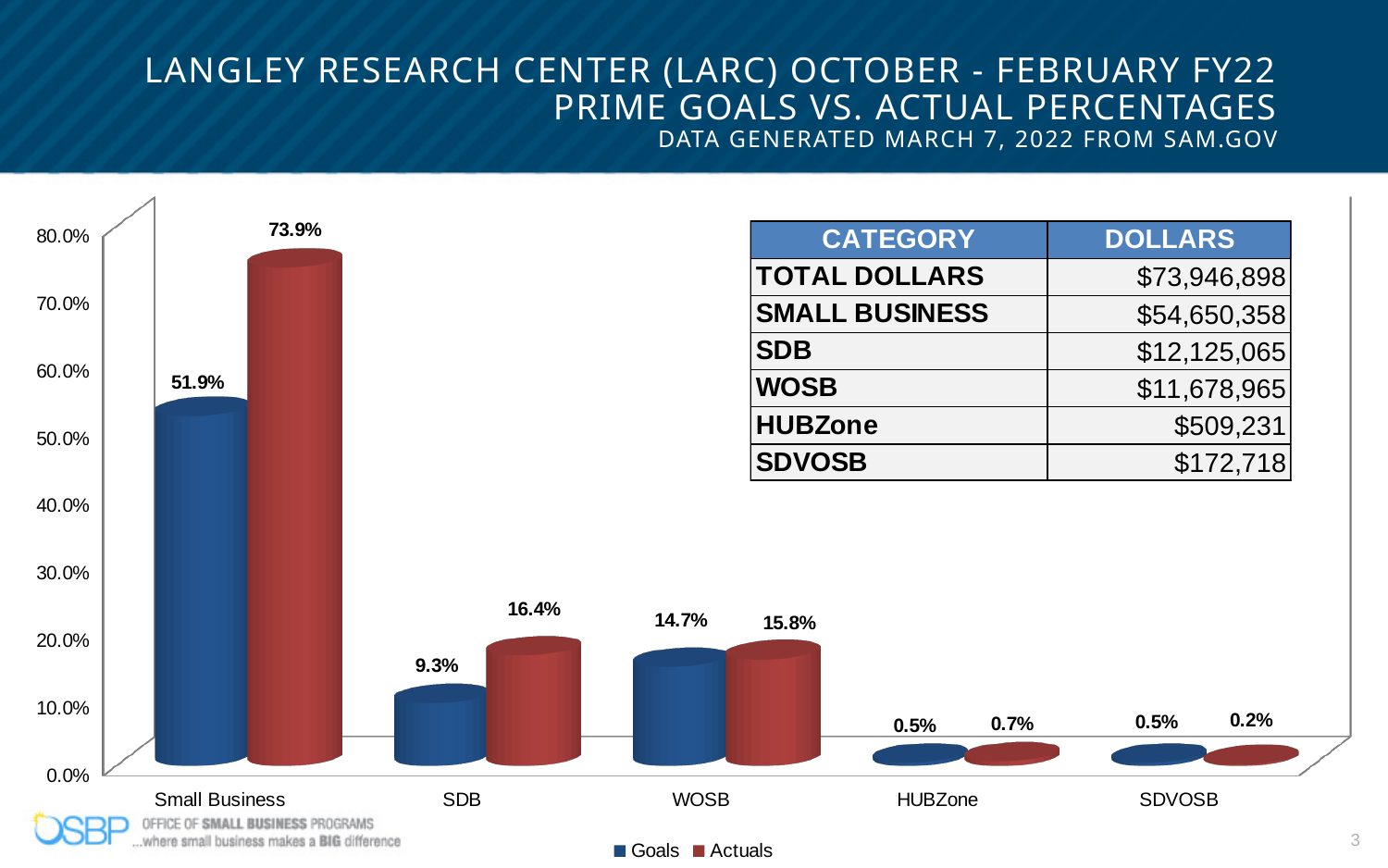
Which is larger for SDVOSB, the Goals value or the Actuals value? Goals What is the Goals value for HUBZone? 0.5% How many categories are shown on the x axis of the chart? 5 What kind of chart is shown on the slide? Bar chart What is the Actuals value for WOSB? 15.8% Which category has the highest Actuals value? Small Business What is the Goals value for SDB? 9.3% What is the difference between the Actuals and Goals values for Small Business? 22.0% What is the Actuals value for Small Business? 73.9% How many series does the chart legend list? 2 Is the Goals value for Small Business greater or less than 50.0%? greater Which category has the lowest Actuals value? SDVOSB